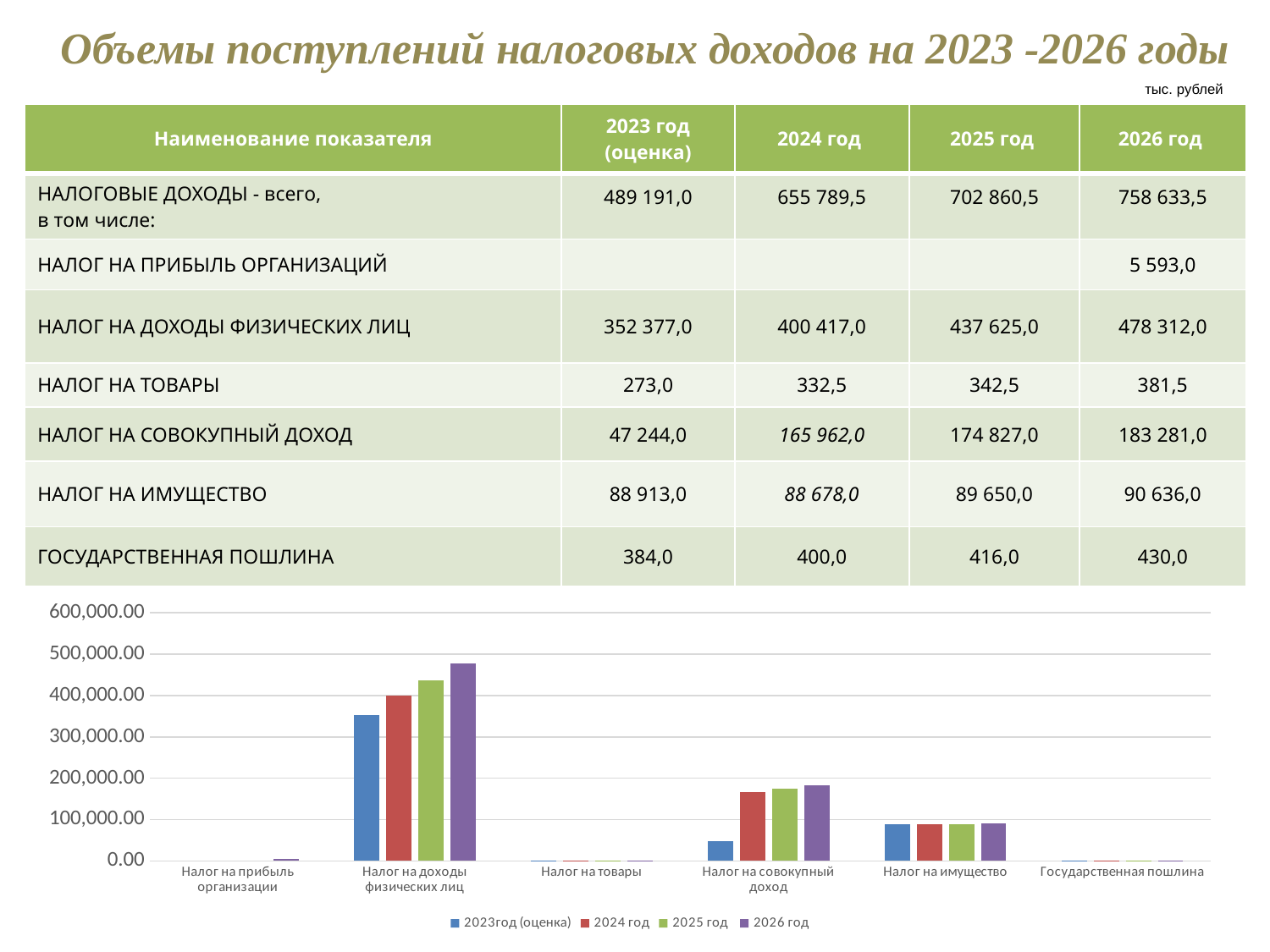
For 2026 год, which is larger: Налог на совокупный доход or Налог на имущество? Налог на совокупный доход According to the table, what is the value for НАЛОГ НА ДОХОДЫ ФИЗИЧЕСКИХ ЛИЦ in 2026 год? 478 312,0 Do the bars for Налог на доходы физических лиц rise or fall from 2023год (оценка) to 2026 год? rise Which series in the chart legend is shown in purple? 2026 год Is the 2026 год value for Налог на доходы физических лиц greater or less than 400,000.00? greater What kind of chart is shown at the bottom of the slide? bar chart How many categories are shown on the x axis of the chart? 6 Is the 2024 год value for Налог на совокупный доход greater or less than 100,000.00? greater Which category has the highest bars in the chart? Налог на доходы физических лиц Is the 2025 год value for Налог на имущество greater or less than 100,000.00? less How many series does the chart legend list? 4